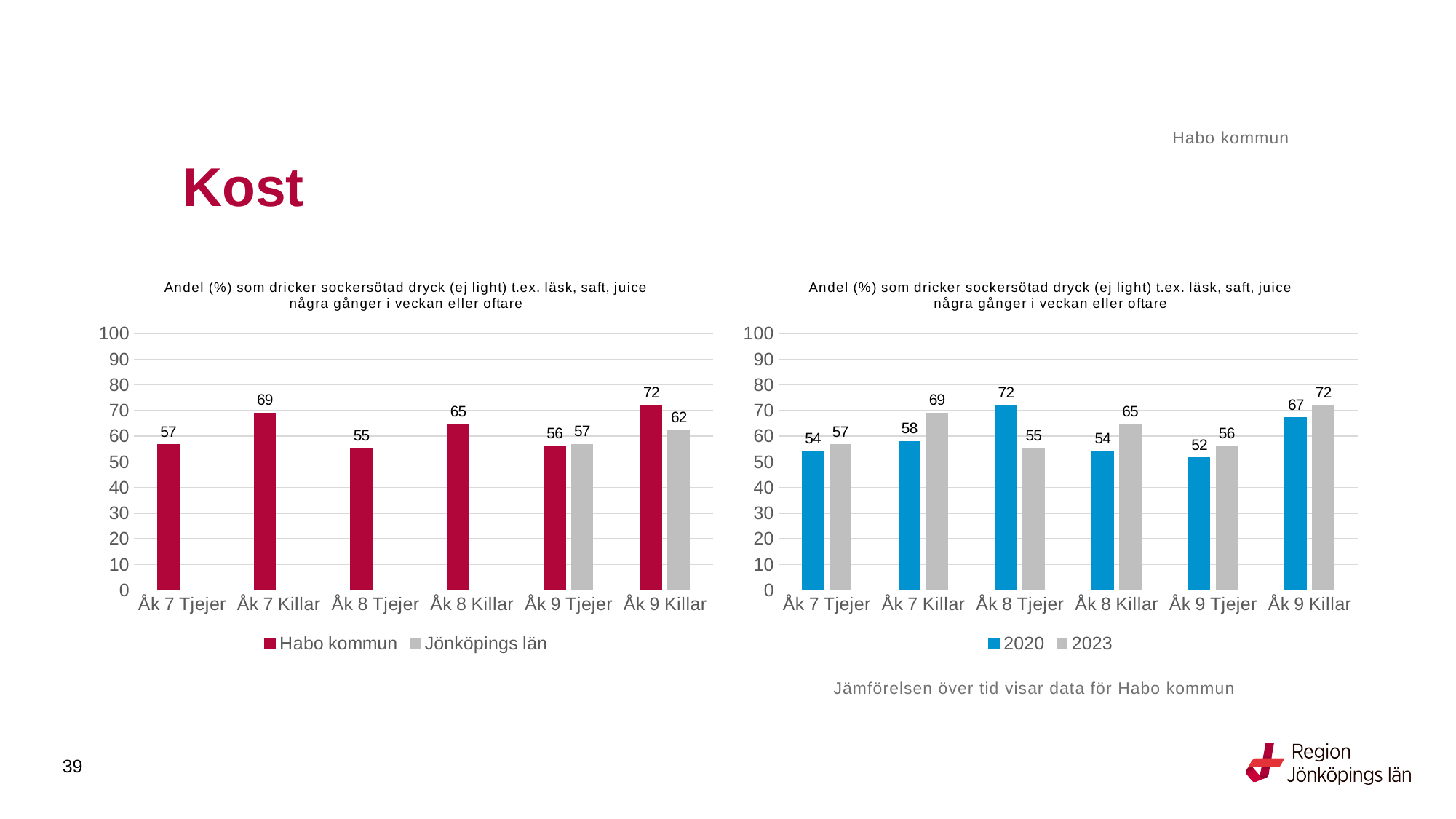
In the left chart, what is the difference between Habo kommun and Jönköpings län for Åk 9 Killar? 10 In the right chart, what is the value for 2020 for Åk 8 Tjejer? 72 What kind of chart is the right chart? Bar chart In the left chart, which category has the lowest value for Habo kommun? Åk 8 Tjejer In the left chart, how many series does the legend list? 2 In the right chart, which is larger for Åk 7 Killar: 2020 or 2023? 2023 In the right chart, which category has the lowest value for 2020? Åk 9 Tjejer In the left chart, what is the value for Jönköpings län for Åk 9 Killar? 62 In the right chart, what is the value for 2023 for Åk 9 Tjejer? 56 In the left chart, which category has the highest value for Habo kommun? Åk 9 Killar In the right chart, what is the difference between 2020 and 2023 for Åk 8 Tjejer? 17 In the left chart, what is the value for Habo kommun for Åk 7 Killar? 69